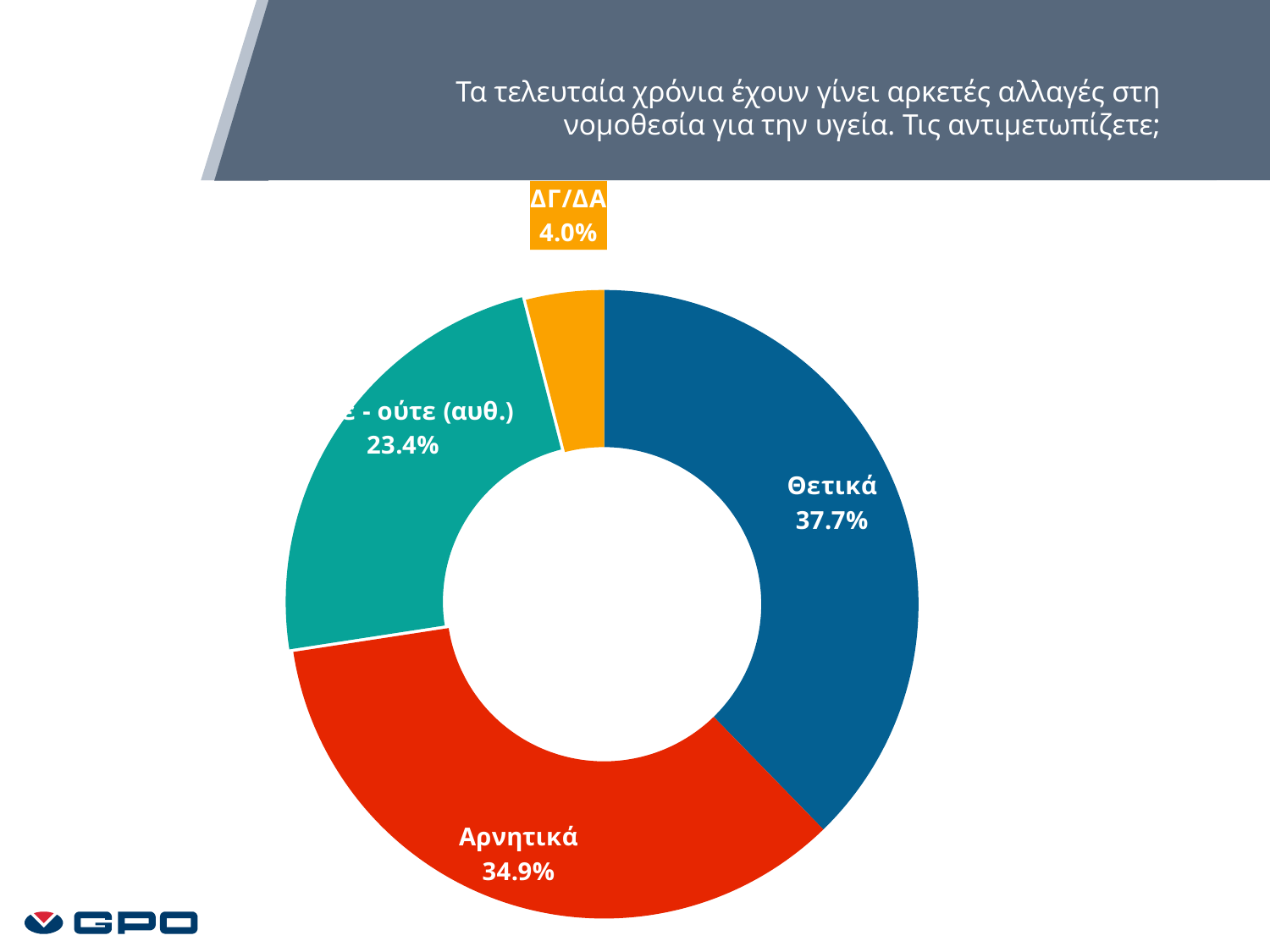
What percentage of respondents answered Θετικά? 37.7% What type of chart is shown on the slide? Pie chart (donut) How many slices does the chart have? 4 Which response category has the smallest share in the chart? ΔΓ/ΔΑ Which response category has the largest share in the chart? Θετικά What is the value shown for the ΔΓ/ΔΑ slice? 4.0% What percentage is shown on the teal slice of the chart? 23.4% Which is larger, the share for Θετικά or the share for Αρνητικά? Θετικά By how many percentage points does Θετικά exceed Αρνητικά? 2.8 percentage points What colour is the Αρνητικά slice? Red What percentage of respondents answered Αρνητικά? 34.9% What is the combined share of Θετικά and Αρνητικά? 72.6%